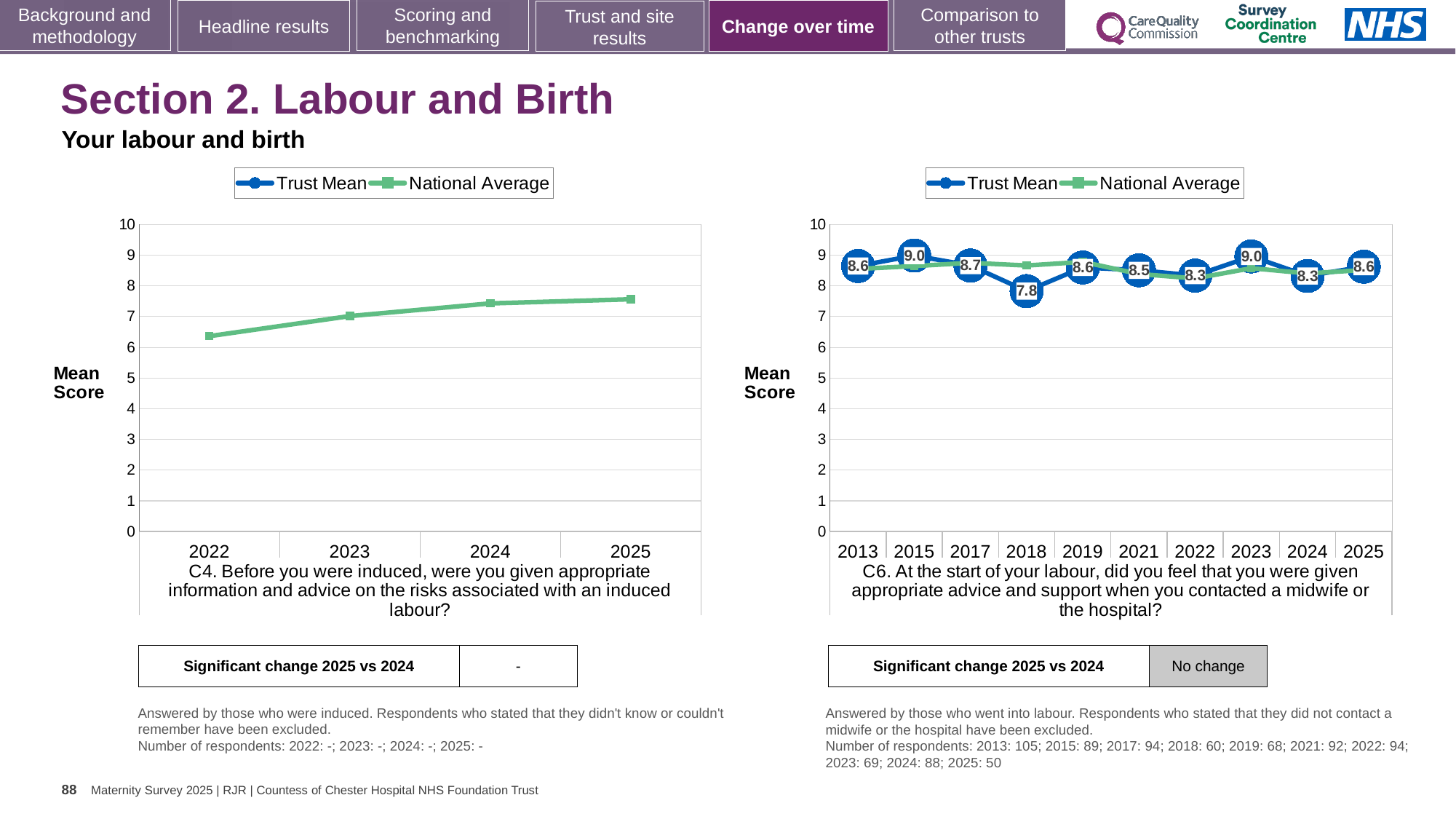
How many years are shown on the x axis of the C6 chart on the right? 10 In the C6 chart on the right, what is the highest Trust Mean score shown? 9.0 In the C6 chart on the right, which year has the higher Trust Mean score, 2017 or 2022? 2017 In the C6 chart on the right, what is the Trust Mean score for 2025? 8.6 In the C4 chart on the left, does the National Average rise or fall from 2022 to 2025? Rise In the C6 chart on the right, what is the difference between the Trust Mean scores for 2023 and 2024? 0.7 What kind of chart is the C4 chart on the left? Line chart In the C4 chart on the left, is the National Average for 2022 greater or less than 7? less In the C6 chart on the right, what is the Trust Mean score for 2021? 8.5 In the C6 chart on the right, which year has the lowest Trust Mean score? 2018 In the C6 chart on the right, what is the Trust Mean score for 2018? 7.8 How many series does the legend of the C4 chart on the left list? 2